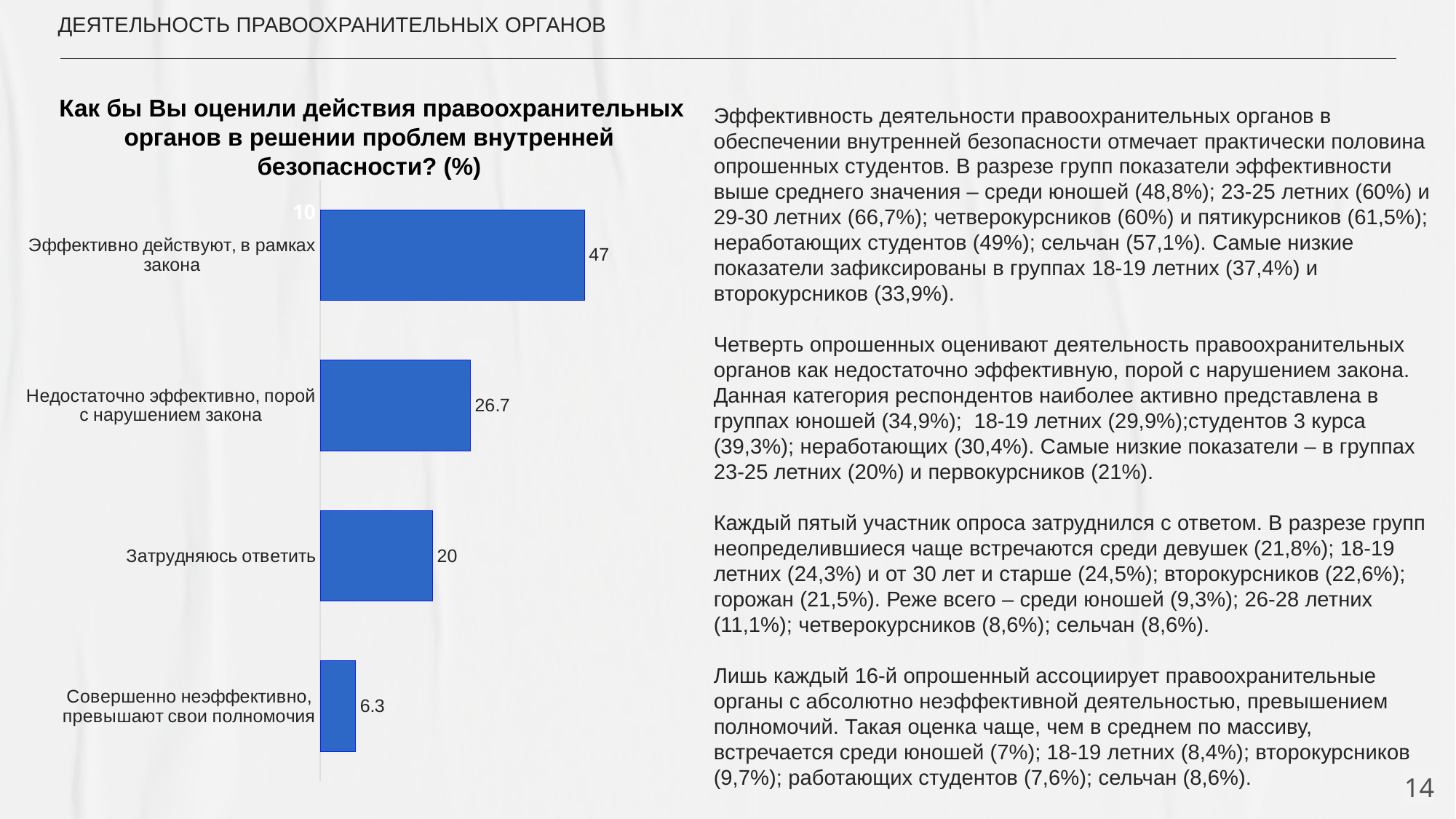
How many categories are shown in the chart? 4 What is the value for "Затрудняюсь ответить"? 20 What is the value for "Эффективно действуют, в рамках закона"? 47 Which is larger: the value for "Недостаточно эффективно, порой с нарушением закона" or the value for "Затрудняюсь ответить"? Недостаточно эффективно, порой с нарушением закона What is the title of the chart? Как бы Вы оценили действия правоохранительных органов в решении проблем внутренней безопасности? (%) What is the difference between the values for "Эффективно действуют, в рамках закона" and "Недостаточно эффективно, порой с нарушением закона"? 20.3 What type of chart is shown on the slide? Bar chart Which category has the highest value? Эффективно действуют, в рамках закона Which category has the lowest value? Совершенно неэффективно, превышают свои полномочия What is the difference between the values for "Затрудняюсь ответить" and "Совершенно неэффективно, превышают свои полномочия"? 13.7 What is the value for "Недостаточно эффективно, порой с нарушением закона"? 26.7 What is the value for "Совершенно неэффективно, превышают свои полномочия"? 6.3